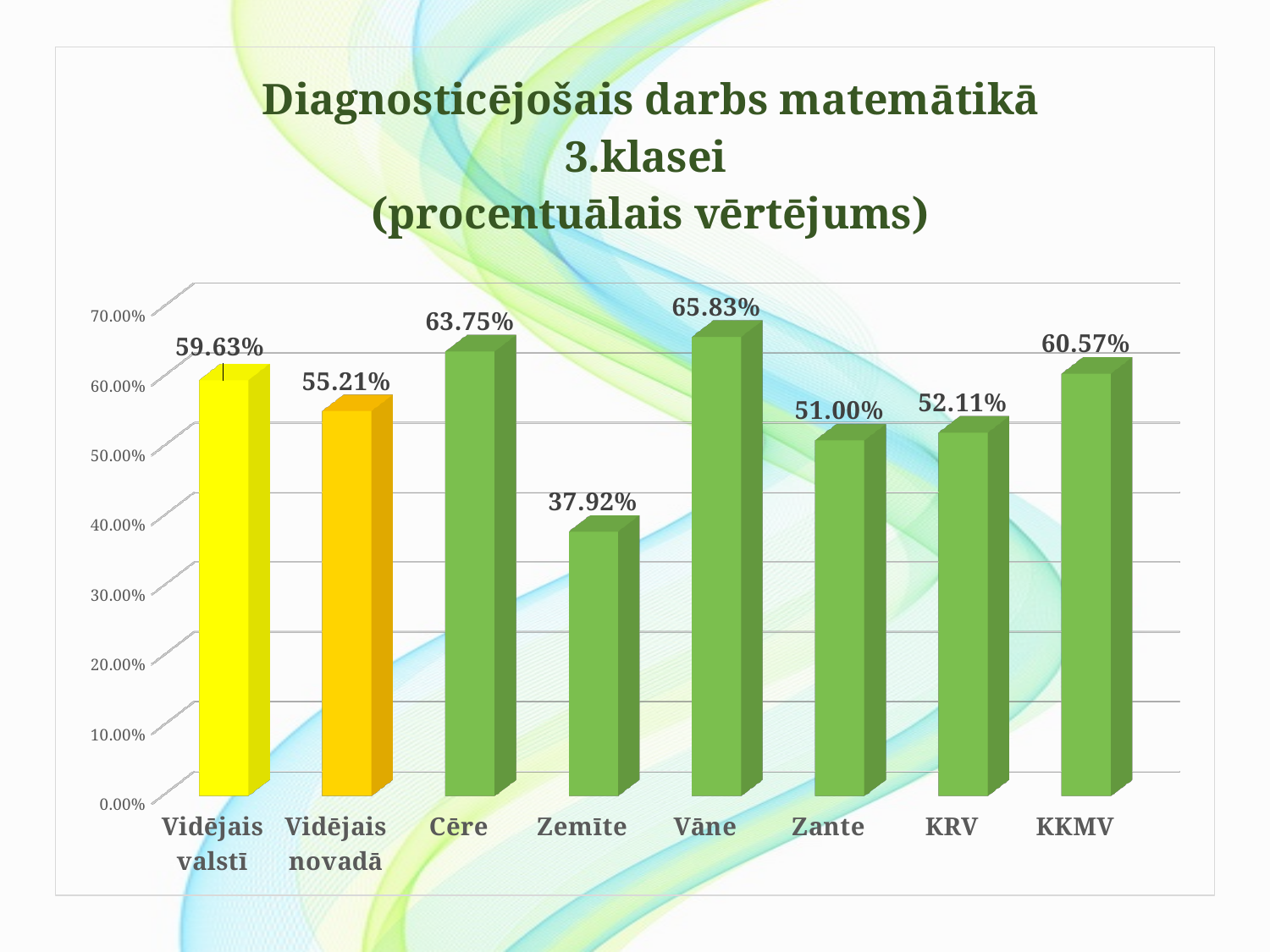
What is the value for Vāne? 65.83% What kind of chart is shown on the slide? bar chart Is the value for Zante greater or less than 60.00%? less Which category has the highest value? Vāne What is the difference between the values for Cēre and Zante? 12.75% Which is larger, the value for Vidējais valstī or the value for KRV? Vidējais valstī What is the value for KKMV? 60.57% What is the title of the chart? Diagnosticējošais darbs matemātikā 3.klasei (procentuālais vērtējums) Which category has the lowest value? Zemīte What is the value for Vidējais novadā? 55.21% What is the value for Zemīte? 37.92% How many categories are shown on the x axis? 8